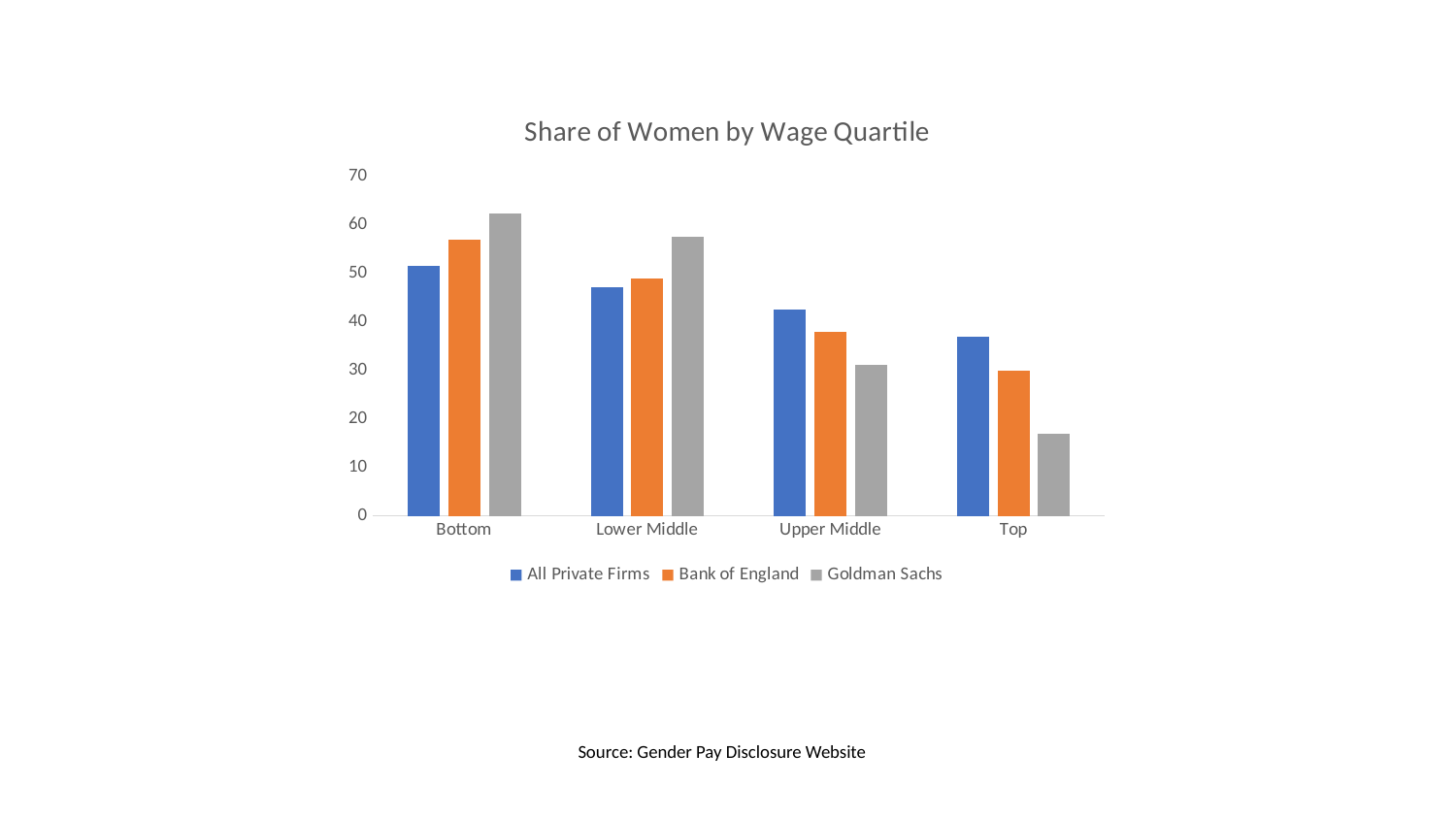
In the Upper Middle quartile, which is larger: All Private Firms or Goldman Sachs? All Private Firms How many series does the legend list? 3 How many wage quartile categories are shown on the x axis? 4 Which series has the highest value in the Bottom quartile? Goldman Sachs What is the title of the chart? Share of Women by Wage Quartile Is the Bank of England value for the Bottom quartile greater or less than 50? greater What type of chart is shown on the slide? bar chart Which series has the lowest value in the Top quartile? Goldman Sachs Is the Goldman Sachs value for the Top quartile greater or less than 20? less In which wage quartile is the Goldman Sachs value highest? Bottom Is the All Private Firms value for the Top quartile greater or less than 40? less Do the Goldman Sachs values rise or fall moving from the Bottom quartile to the Top quartile? fall